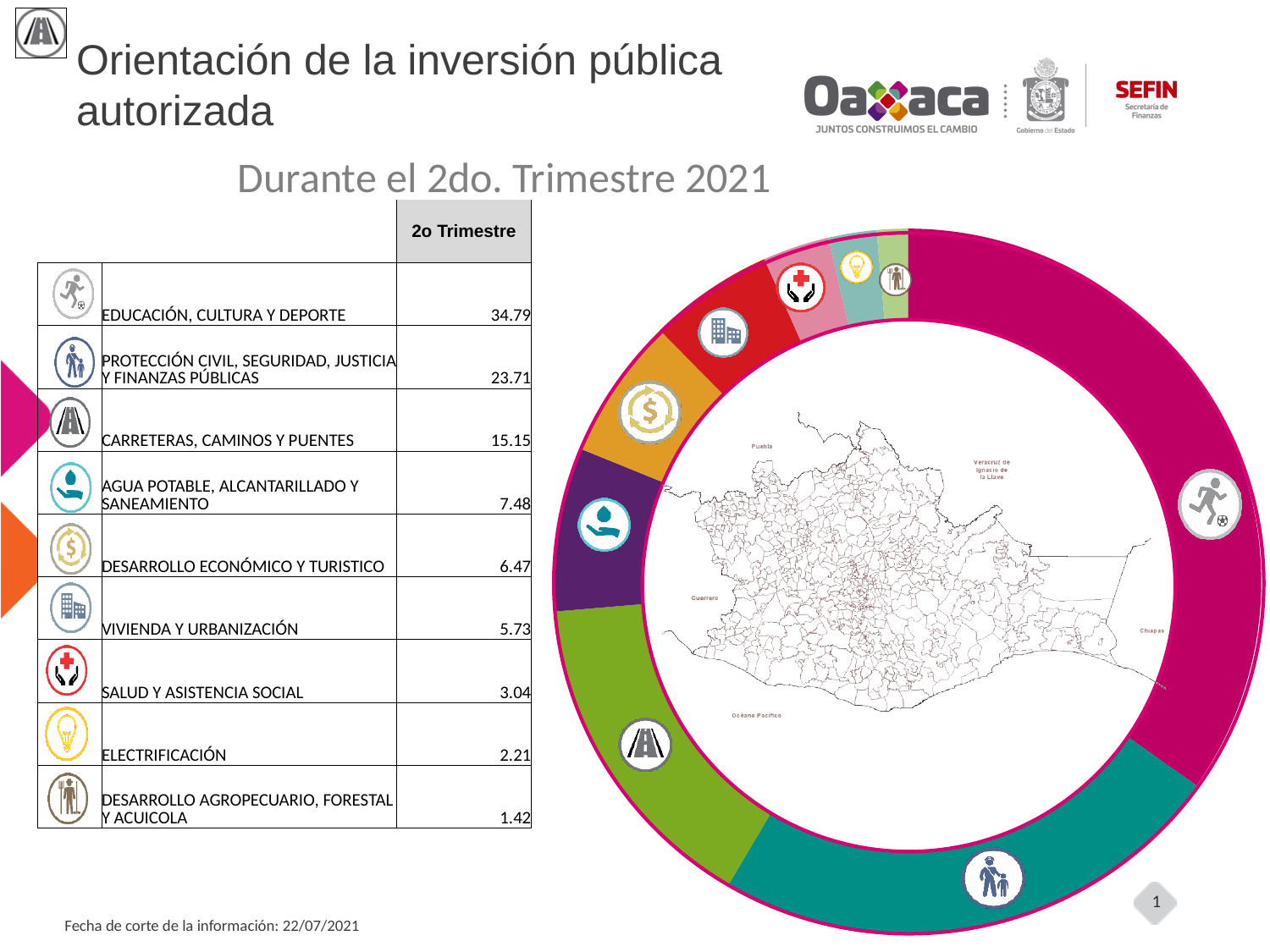
What is the value for ELECTRIFICACIÓN? 2.21 What is the value for CARRETERAS, CAMINOS Y PUENTES? 15.15 What is the value for SALUD Y ASISTENCIA SOCIAL? 3.04 How many categories are plotted in the donut chart? 9 What is the difference between the values for VIVIENDA Y URBANIZACIÓN and SALUD Y ASISTENCIA SOCIAL? 2.69 Which category has the lowest value in the 2o Trimestre data? DESARROLLO AGROPECUARIO, FORESTAL Y ACUICOLA Which category has the highest value in the 2o Trimestre data? EDUCACIÓN, CULTURA Y DEPORTE Which is larger, the value for AGUA POTABLE, ALCANTARILLADO Y SANEAMIENTO or the value for DESARROLLO ECONÓMICO Y TURISTICO? AGUA POTABLE, ALCANTARILLADO Y SANEAMIENTO What period does the chart's subtitle say the data covers? Durante el 2do. Trimestre 2021 What is the value for EDUCACIÓN, CULTURA Y DEPORTE? 34.79 What is the difference between the values for EDUCACIÓN, CULTURA Y DEPORTE and PROTECCIÓN CIVIL, SEGURIDAD, JUSTICIA Y FINANZAS PÚBLICAS? 11.08 What kind of chart is shown on the slide? Pie chart (donut)